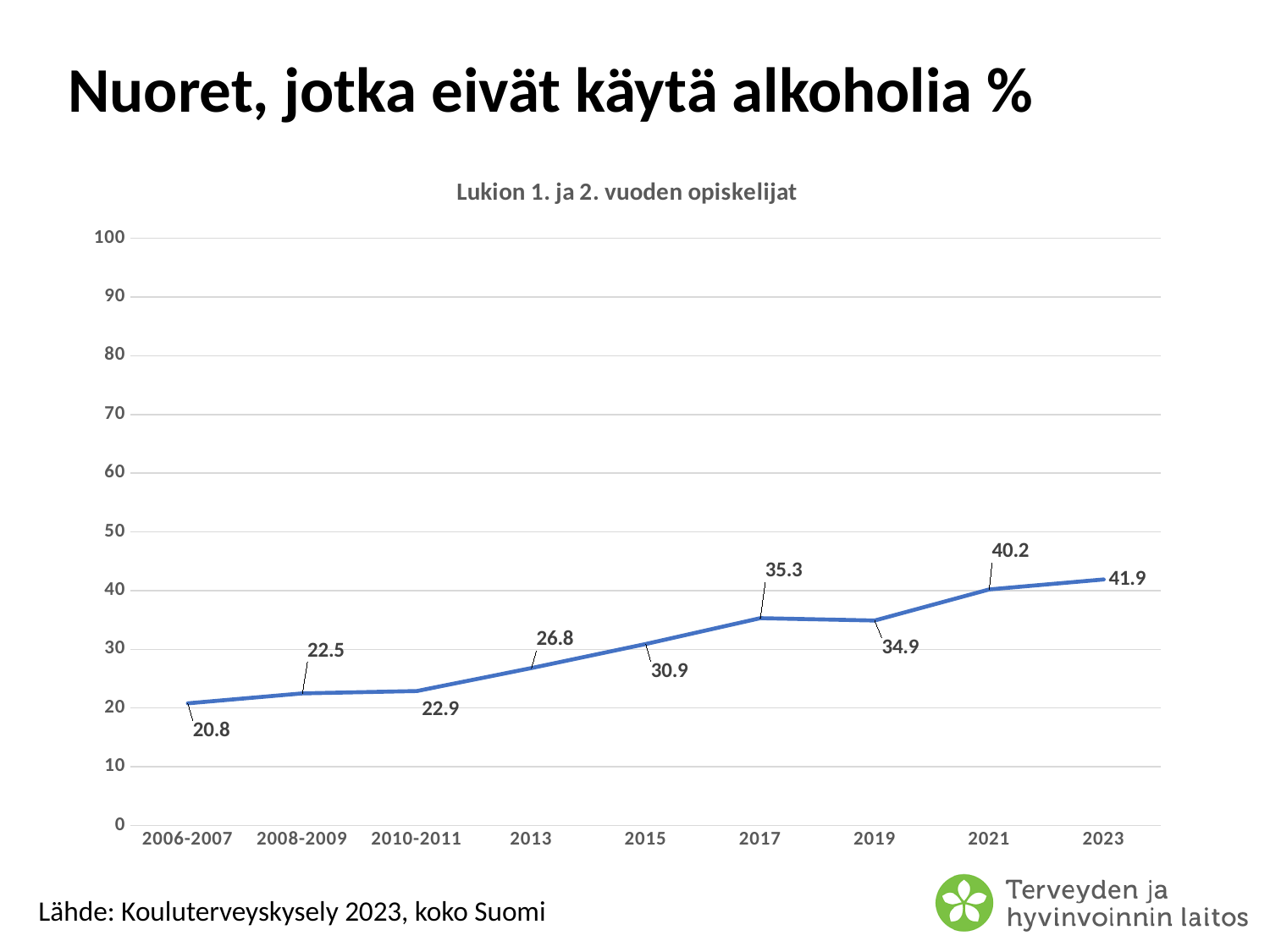
What kind of chart is shown? line chart Do the values generally rise or fall from 2006-2007 to 2023? rise What is the value for 2006-2007? 20.8 How many data points are plotted on the line? 9 What is the difference between the values for 2023 and 2006-2007? 21.1 What is the value for 2017? 35.3 Which is larger, the value for 2017 or the value for 2019? 2017 What is the title of the chart? Lukion 1. ja 2. vuoden opiskelijat Which year has the highest value? 2023 Is the value for 2021 greater or less than 50? less Which year has the lowest value? 2006-2007 What is the value for 2023? 41.9